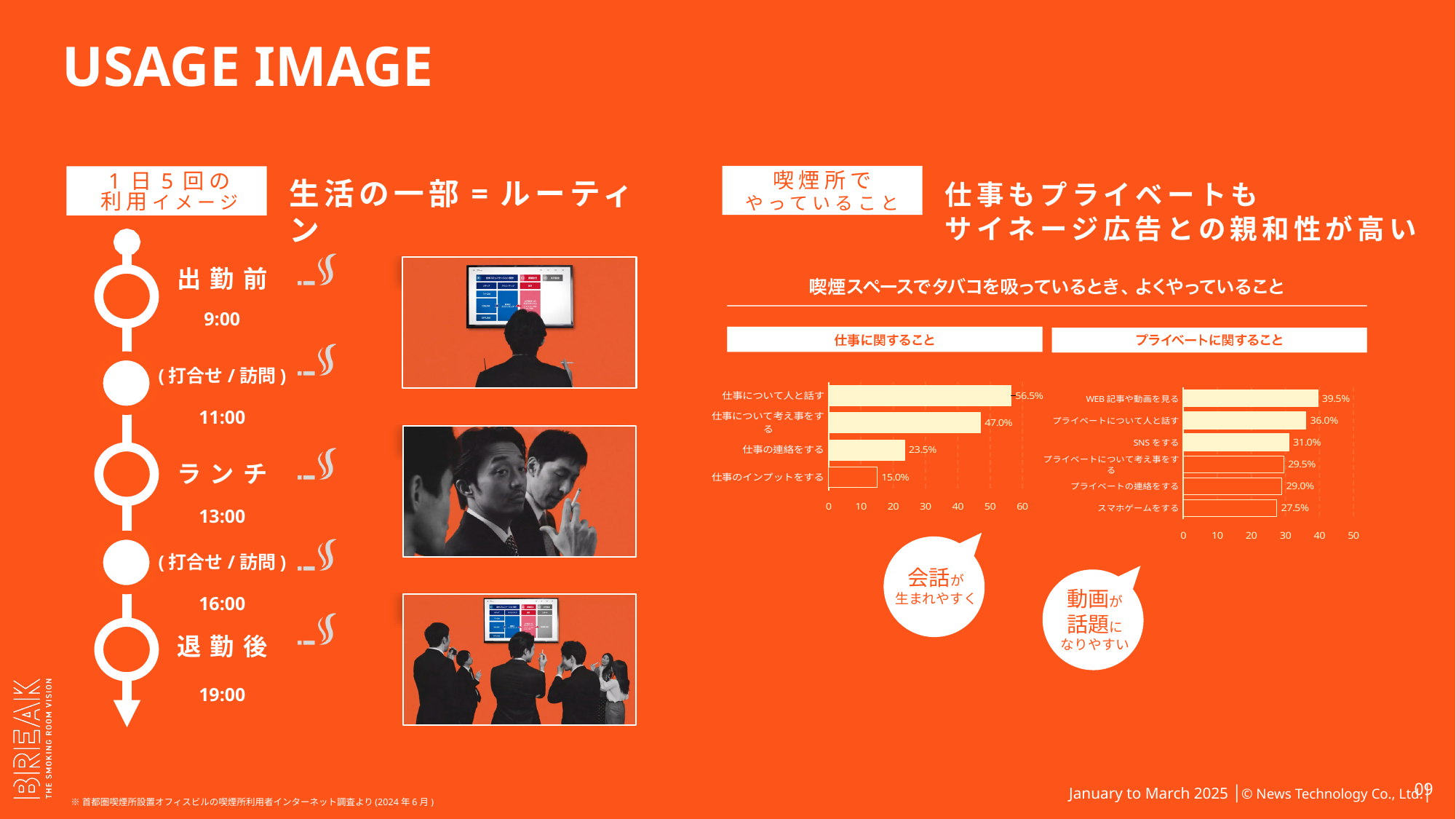
In the 仕事に関すること chart, what is the value for 仕事について人と話す? 56.5% In the 仕事に関すること chart, what is the value for 仕事のインプットをする? 15.0% In the プライベートに関すること chart, what is the value for スマホゲームをする? 27.5% What type of chart is the 仕事に関すること chart? Bar chart In the プライベートに関すること chart, what is the value for SNSをする? 31.0% How many categories are shown in the プライベートに関すること chart? 6 In the 仕事に関すること chart, what is the difference between 仕事について人と話す and 仕事について考え事をする? 9.5% In the プライベートに関すること chart, which category has the lowest value? スマホゲームをする In the 仕事に関すること chart, which category has the highest value? 仕事について人と話す In the プライベートに関すること chart, what is the difference between WEB記事や動画を見る and プライベートについて人と話す? 3.5% How many categories are shown in the 仕事に関すること chart? 4 In the 仕事に関すること chart, which is larger: 仕事の連絡をする or 仕事のインプットをする? 仕事の連絡をする